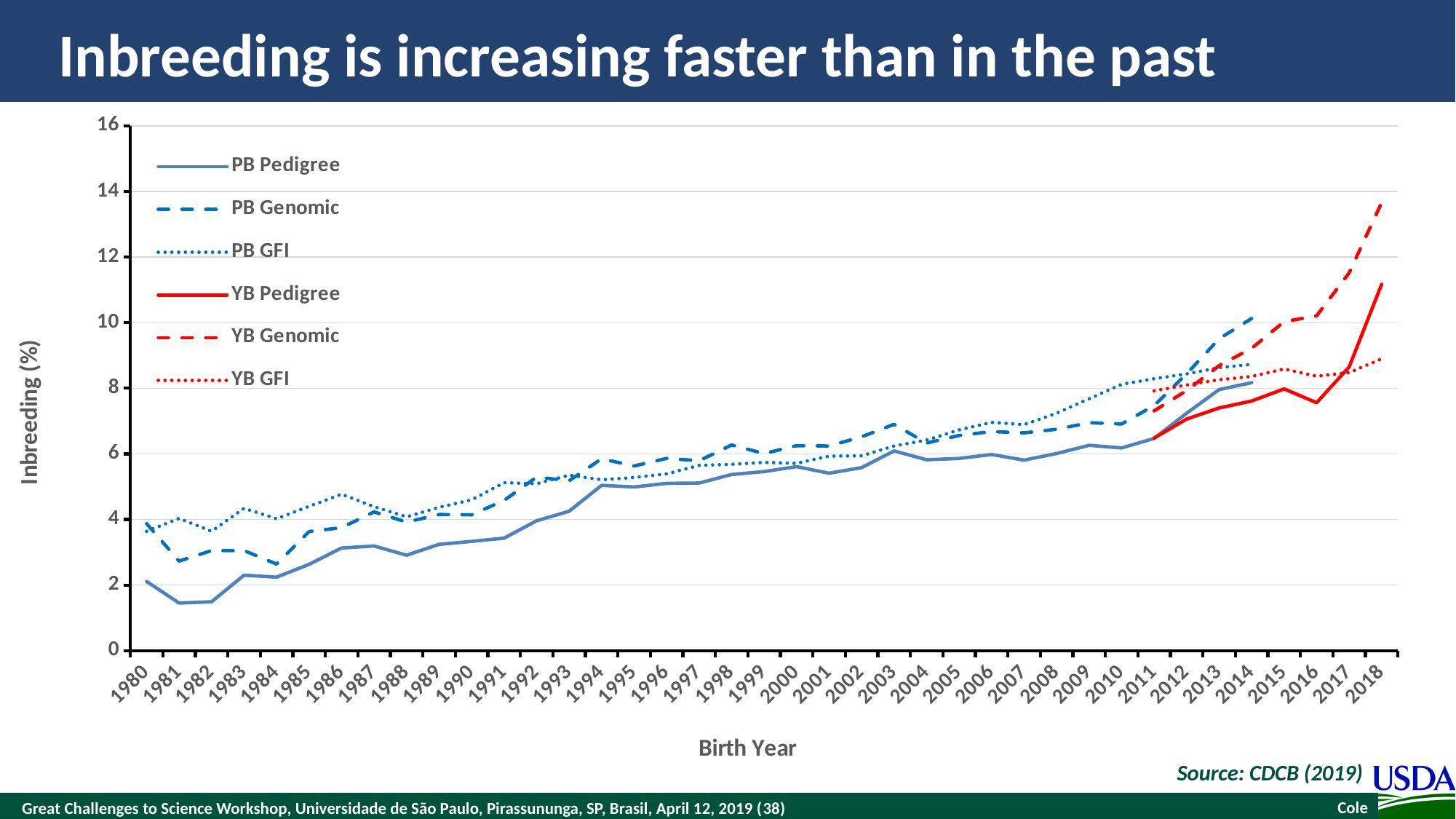
Is the value for YB GFI in 2018 greater or less than 8? greater How many birth years are shown on the x axis? 39 Is the value for PB Pedigree in 1981 greater or less than 2? less Is the value for YB Genomic in 2018 greater or less than 12? greater How many series does the legend list? 6 What is the label of the y axis? Inbreeding (%) Does the PB Pedigree line generally rise or fall from 1980 to 2014? rise In 2018, which is larger: YB Genomic or YB Pedigree? YB Genomic Which series reaches the highest inbreeding value on the chart? YB Genomic What kind of chart is shown on the slide? line chart